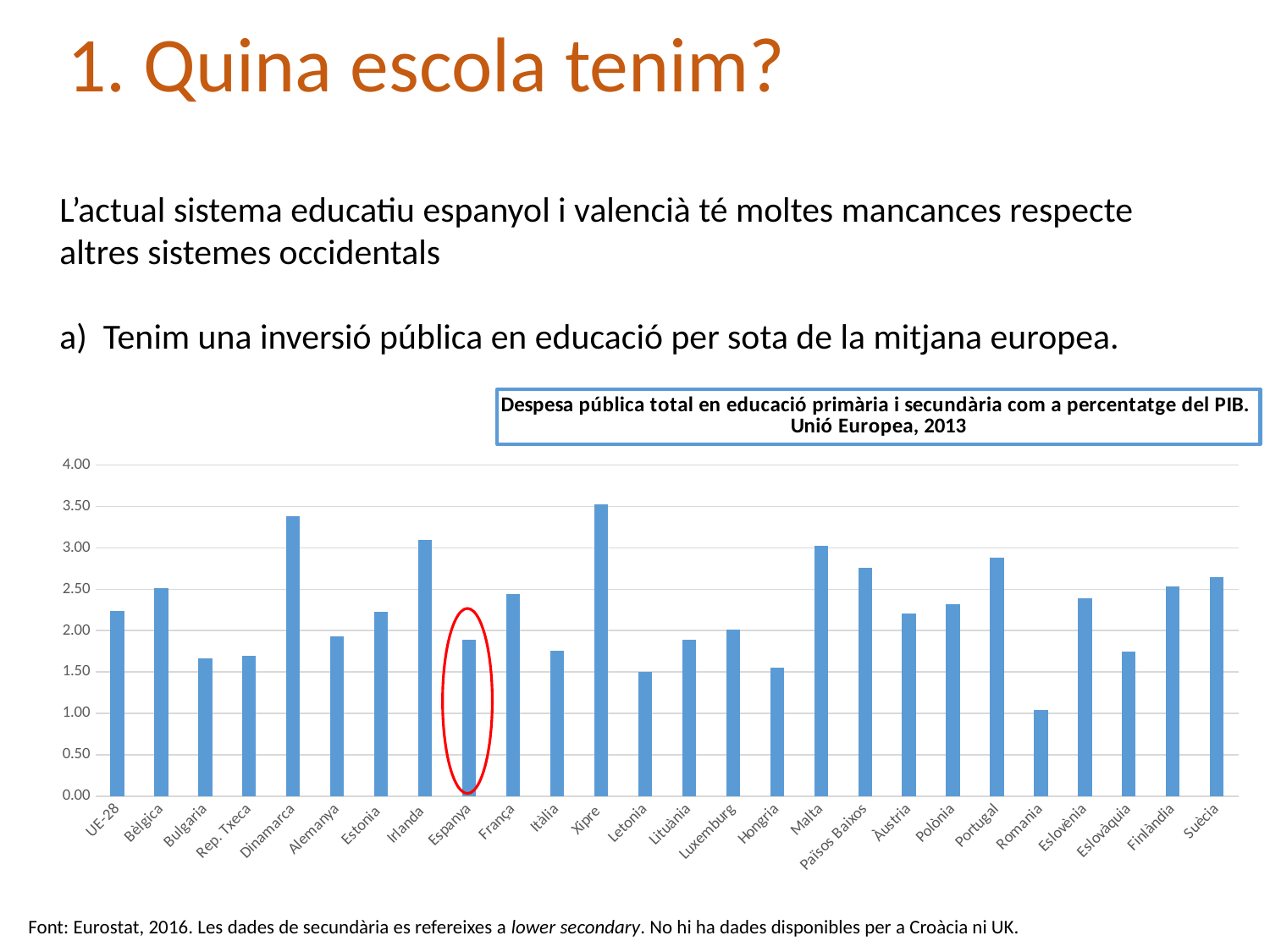
Is the value for Hongria greater or less than 2.00? less Which has a larger value, Irlanda or França? Irlanda Which category has the highest value on the chart? Xipre Is the value for Dinamarca greater or less than 3.00? greater Which has a larger value, Espanya or UE-28? UE-28 Is the value for Romania greater or less than 1.50? less How many categories (bars) are plotted on the chart? 26 Which category has the lowest value on the chart? Romania What kind of chart is shown on the slide? bar chart Which country's bar is circled in red on the chart? Espanya